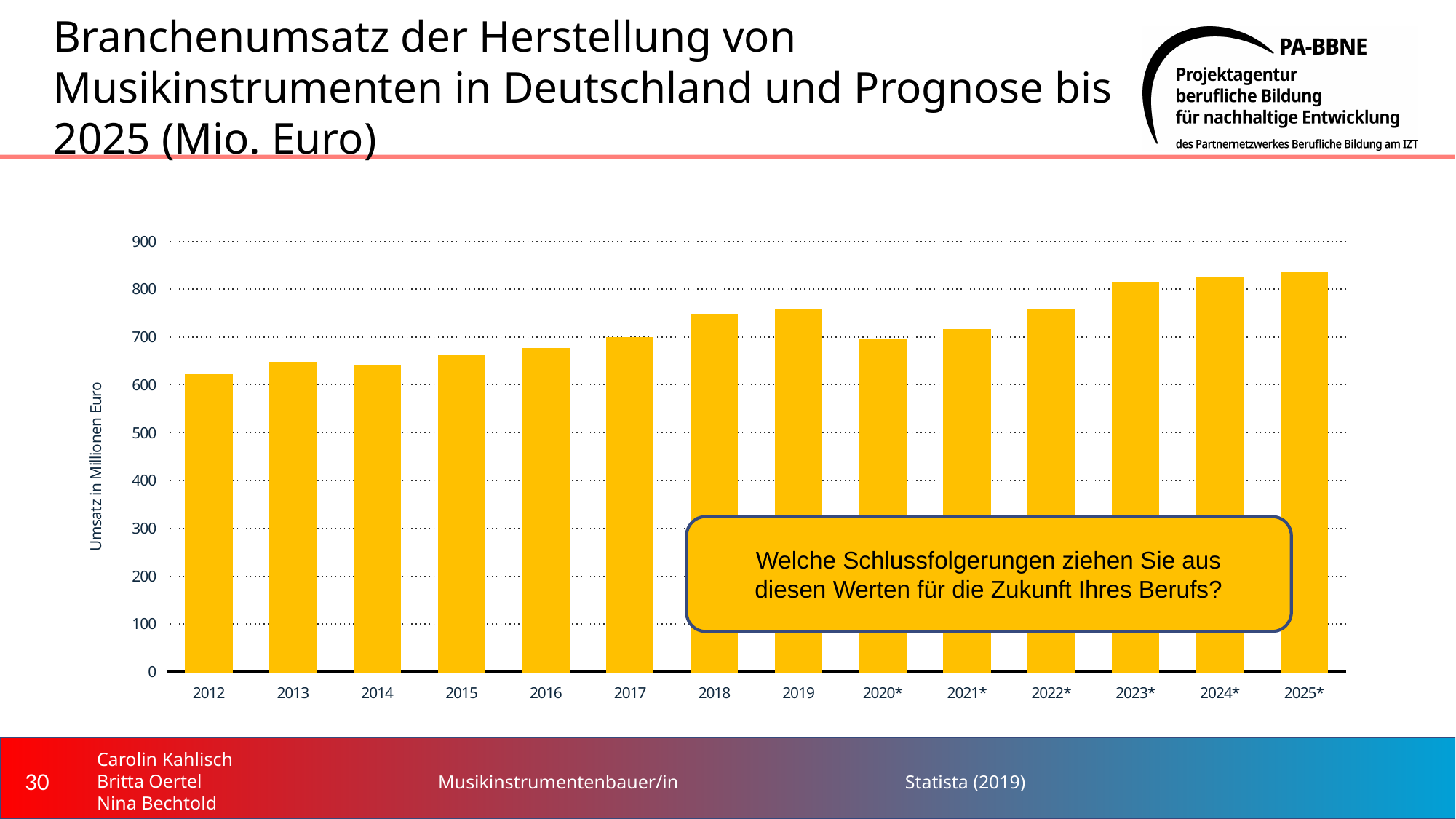
Which year has the lowest bar in the chart? 2012 Which is larger, the value for 2019 or the value for 2020*? 2019 What kind of chart is shown on the slide? bar chart Is the value for 2023* greater or less than 800? greater Which is larger, the value for 2012 or the value for 2018? 2018 Do the values generally rise or fall from 2012 to 2025*? rise Is the value for 2018 greater or less than 800? less Which year has the highest bar in the chart? 2025* What is the label on the y axis of the chart? Umsatz in Millionen Euro Is the value for 2019 greater or less than 700? greater How many years are shown on the x axis of the chart? 14